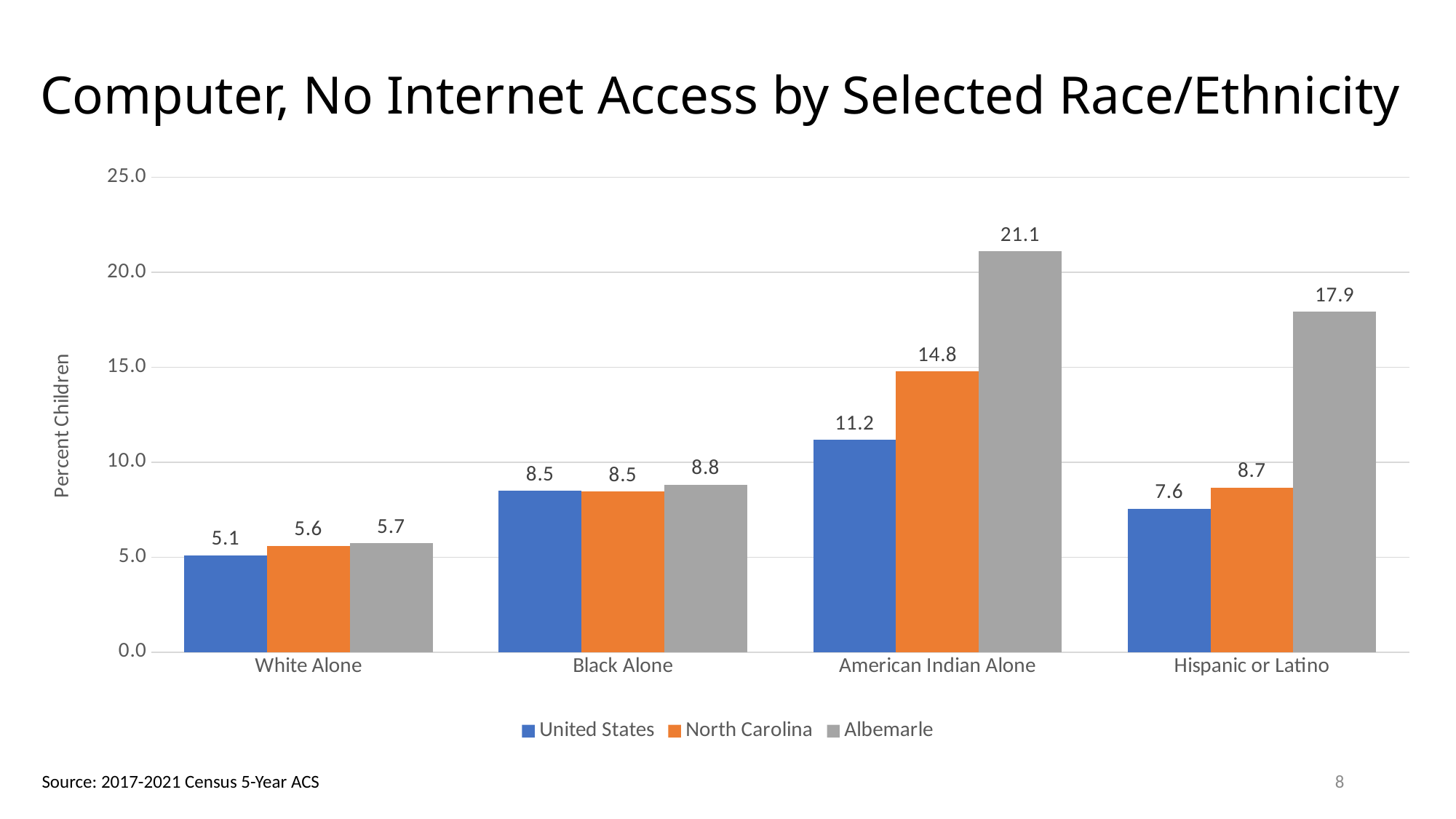
What is the United States value for Hispanic or Latino? 7.6 What is the Albemarle value for American Indian Alone? 21.1 What type of chart is shown on the slide? bar chart What is the North Carolina value for White Alone? 5.6 Which category has the highest Albemarle value? American Indian Alone Is the Albemarle value for Hispanic or Latino greater or less than 15.0? greater Which is larger for Black Alone: the Albemarle value or the United States value? Albemarle What is the difference between the North Carolina and United States values for American Indian Alone? 3.6 Which category has the lowest United States value? White Alone How many race/ethnicity categories are shown on the x axis? 4 How many series does the legend list? 3 What is the difference between the Albemarle and North Carolina values for Hispanic or Latino? 9.2